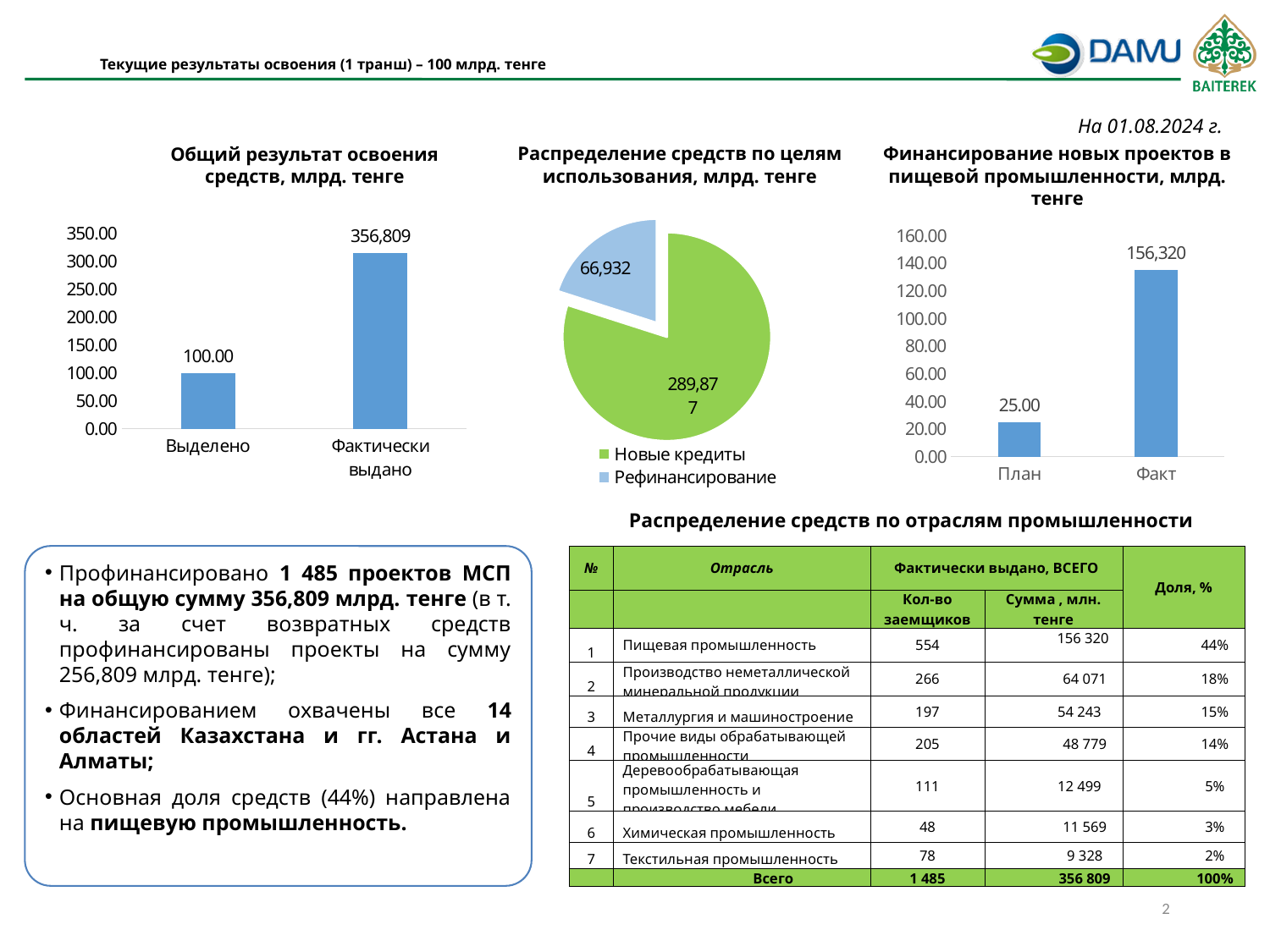
In the pie chart 'Распределение средств по целям использования, млрд. тенге', what is the value for 'Рефинансирование'? 66,932 In the chart 'Общий результат освоения средств, млрд. тенге', what is the value for 'Фактически выдано'? 356,809 In the chart 'Общий результат освоения средств, млрд. тенге', what is the value for 'Выделено'? 100.00 How many categories are shown on the x axis of the chart 'Финансирование новых проектов в пищевой промышленности, млрд. тенге'? 2 In the chart 'Общий результат освоения средств, млрд. тенге', which category has the higher value? Фактически выдано How many entries does the legend of the pie chart 'Распределение средств по целям использования, млрд. тенге' list? 2 In the pie chart 'Распределение средств по целям использования, млрд. тенге', what is the value for 'Новые кредиты'? 289,877 In the pie chart 'Распределение средств по целям использования, млрд. тенге', which slice is larger? Новые кредиты What kind of chart is 'Общий результат освоения средств, млрд. тенге'? bar chart In the chart 'Финансирование новых проектов в пищевой промышленности, млрд. тенге', what is the value for 'План'? 25.00 In the chart 'Финансирование новых проектов в пищевой промышленности, млрд. тенге', what is the value for 'Факт'? 156,320